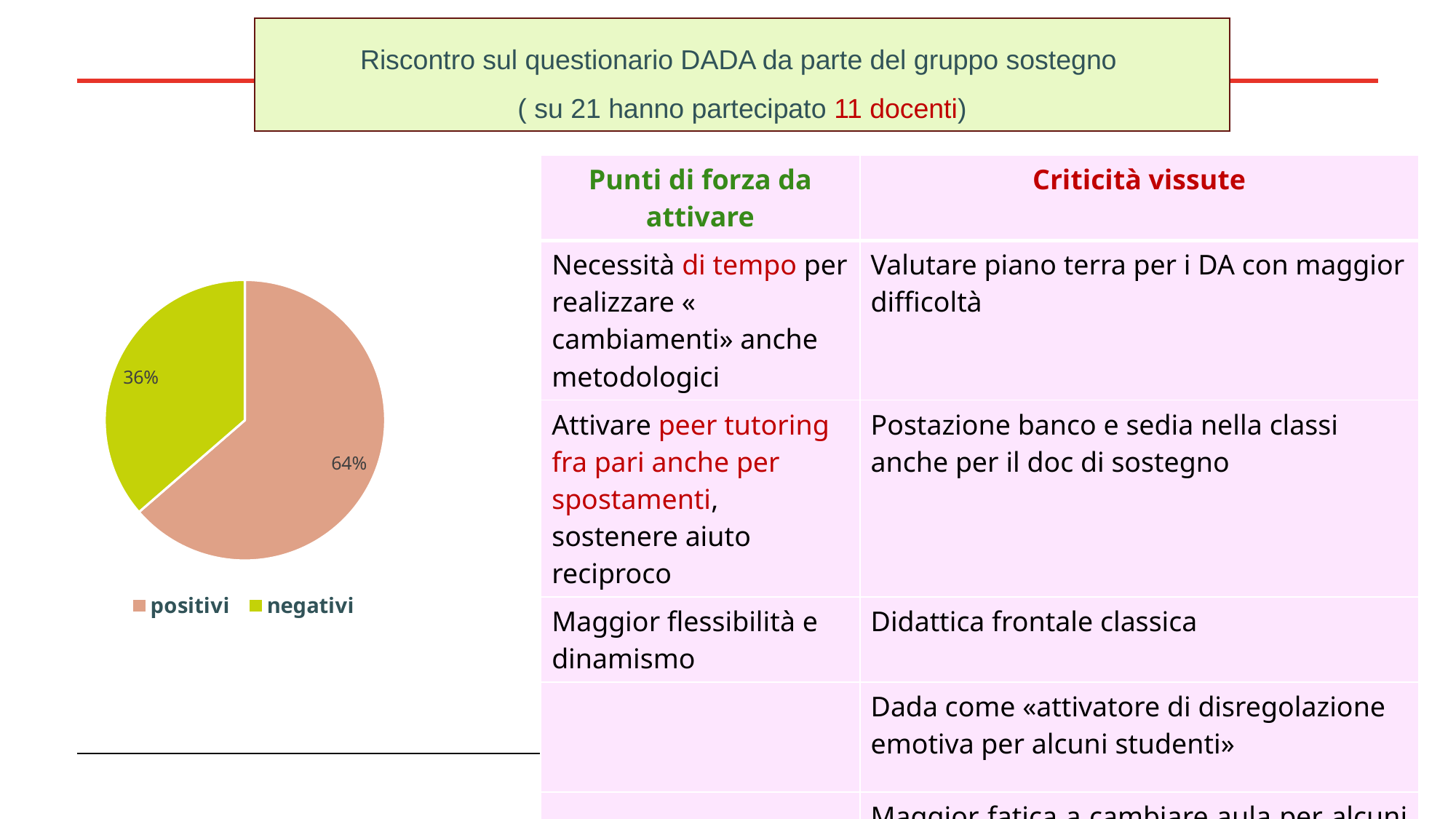
What type of chart is shown on the slide? pie chart Which slice of the pie chart is the largest? positivi What is the difference in percentage points between the "positivi" and "negativi" slices? 28 What colour is the "negativi" slice in the pie chart? yellow-green What percentage of the pie chart is labelled "negativi"? 36% What share of the pie does the "negativi" slice represent? 36% How many entries does the legend of the pie chart list? 2 Which slice of the pie chart is the smallest? negativi How many slices does the pie chart have? 2 What percentage of the pie chart is labelled "positivi"? 64% What are the two legend entries of the pie chart? positivi, negativi Which is larger in the pie chart, "positivi" or "negativi"? positivi